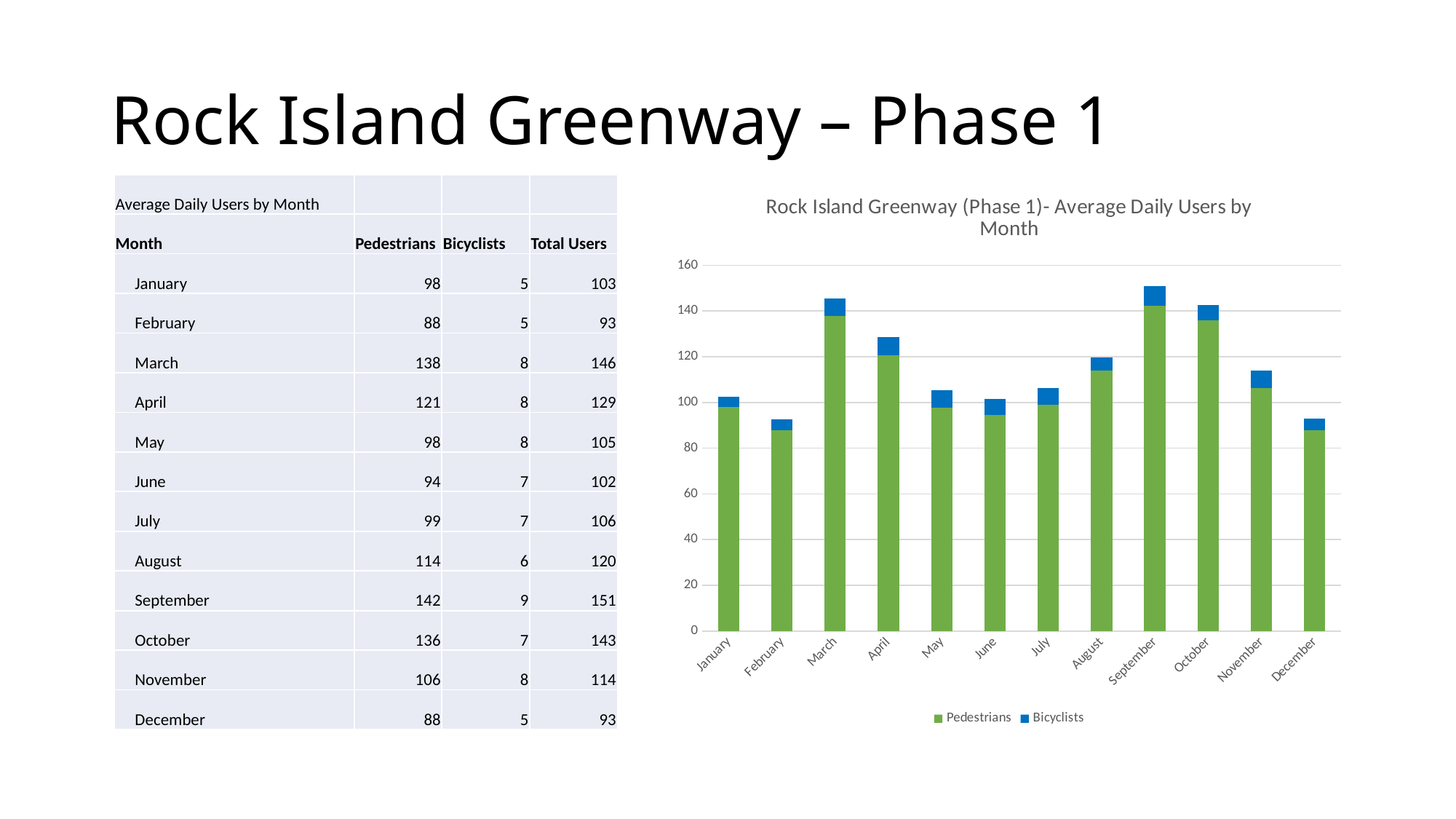
Which is larger, the Pedestrians value for April or for November? April What is the Pedestrians value for March? 138 What kind of chart is shown on the slide? Stacked bar chart How many series does the chart legend list? 2 Is the total bar for February greater or less than 100? less Which colour represents Bicyclists in the chart? Blue Which month has the highest total bar in the chart? September What is the total height of the stacked bar for October? 143 Is the total bar for March greater or less than 140? greater What is the Bicyclists value for September? 9 How many months are plotted along the x axis of the chart? 12 What is the difference between the Pedestrians values for September and August? 28